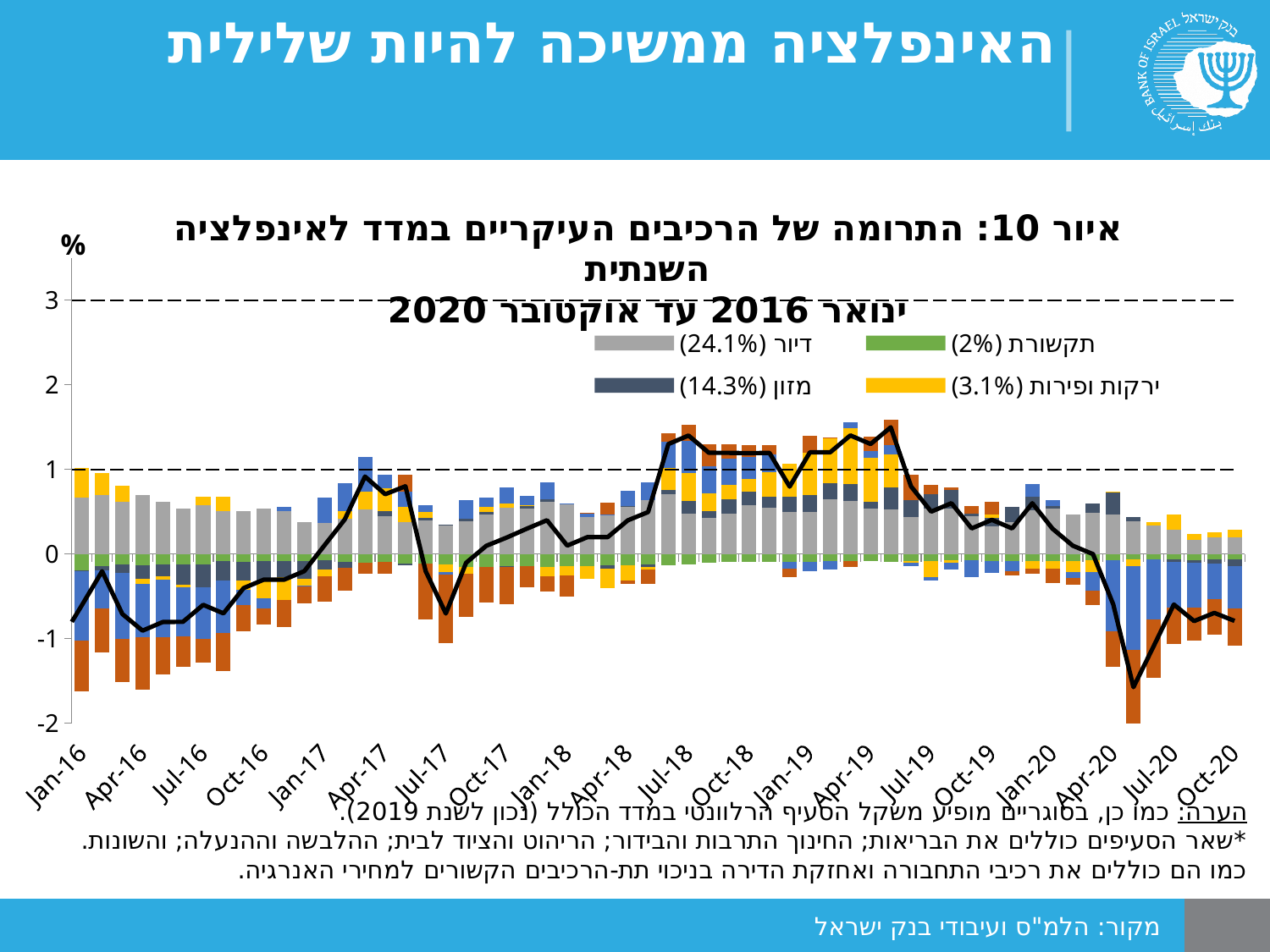
Is the value of the black line at Apr-19 greater or less than 1? greater What percentage is shown in the legend next to מזון? 14.3% Is the value of the black line at Jan-16 greater or less than 0? less How many series does the chart's legend list? 4 How many date labels are shown on the x axis? 20 Does the black line rise or fall between Jul-19 and Jul-20? fall Is the value of the black line at Jul-18 greater or less than 1? greater Is the black line higher at Jul-18 or at Jan-17? Jul-18 What kind of chart is shown on the slide? stacked bar chart with a line What percentage is shown in the legend next to דיור? 24.1%